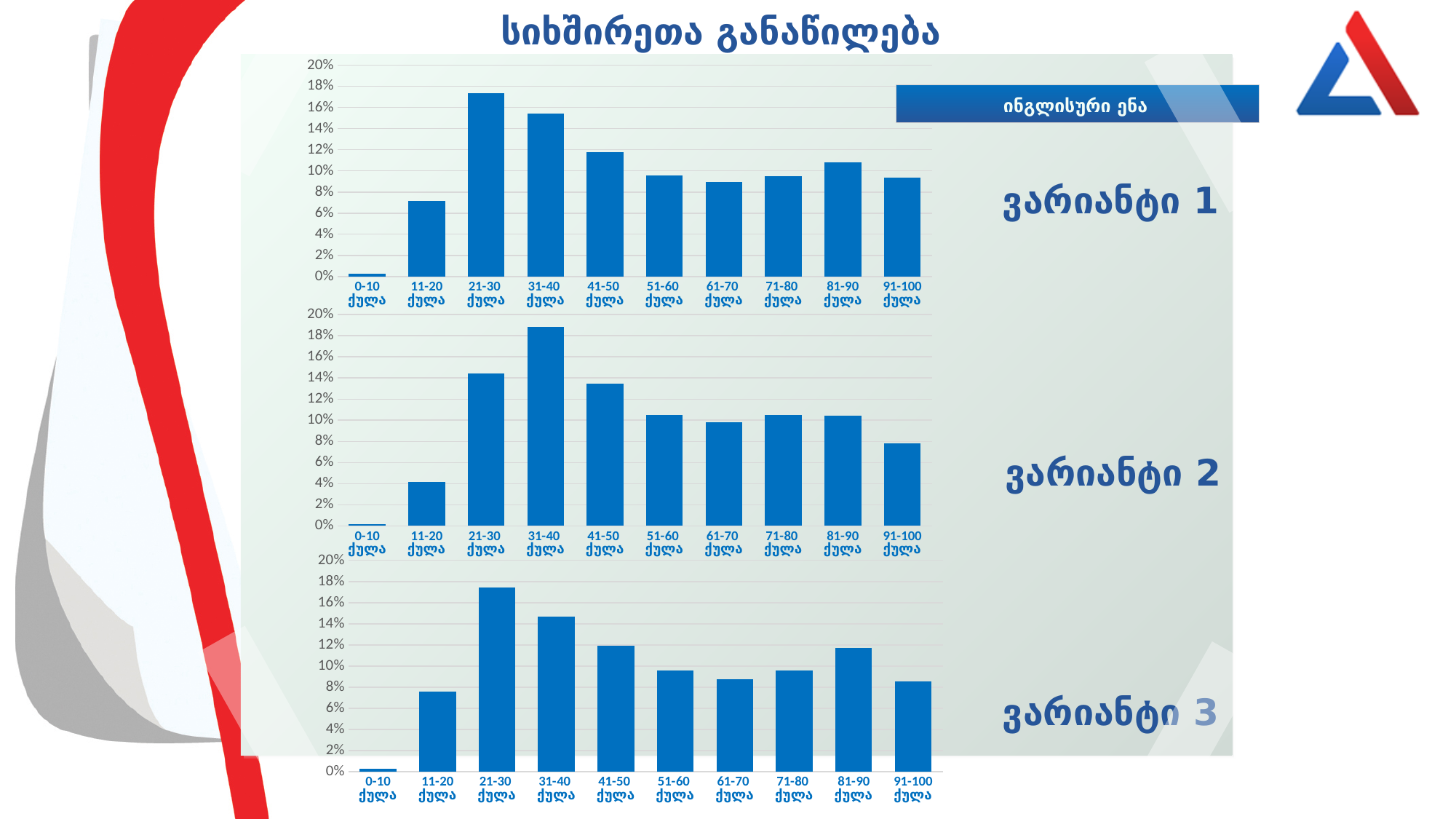
How many score categories are shown on the x axis of the ვარიანტი 2 chart? 10 In the ვარიანტი 2 chart, which is larger: the value for 21-30 ქულა or for 31-40 ქულა? 31-40 ქულა In the ვარიანტი 3 chart, is the value for 91-100 ქულა greater or less than 10%? less In the ვარიანტი 2 chart, which score category has the highest bar? 31-40 ქულა What is the title shown at the top of the slide above the charts? სიხშირეთა განაწილება In the ვარიანტი 1 chart, is the value for 41-50 ქულა greater or less than 10%? greater In the ვარიანტი 3 chart, which score category has the highest bar? 21-30 ქულა In the ვარიანტი 1 chart, which score category has the highest bar? 21-30 ქულა In the ვარიანტი 2 chart, which score category has the lowest bar? 0-10 ქულა In the ვარიანტი 3 chart, which is larger: the value for 41-50 ქულა or for 51-60 ქულა? 41-50 ქულა In the ვარიანტი 2 chart, is the value for 11-20 ქულა greater or less than 6%? less What kind of chart is used for ვარიანტი 1? Bar chart